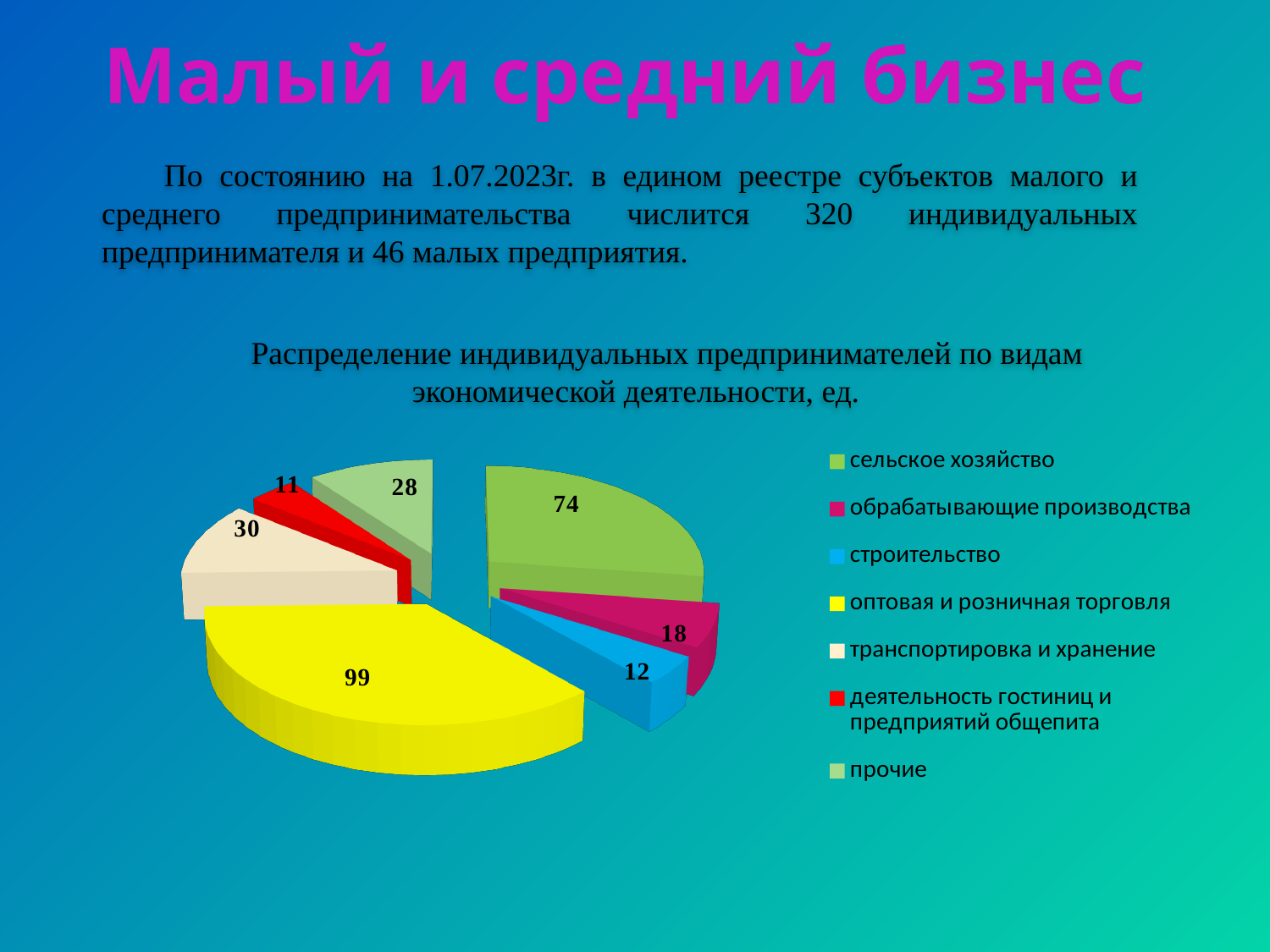
Which category has the largest slice of the pie? оптовая и розничная торговля How many categories does the pie chart have? 7 Which category has the smallest slice of the pie? деятельность гостиниц и предприятий общепита What is the difference between the values for оптовая и розничная торговля and сельское хозяйство? 25 What is the value for сельское хозяйство? 74 What is the title of the chart? Распределение индивидуальных предпринимателей по видам экономической деятельности, ед. What is the value for деятельность гостиниц и предприятий общепита? 11 What type of chart is shown on the slide? pie chart What is the value for оптовая и розничная торговля? 99 What is the value for транспортировка и хранение? 30 Which is larger, the value for обрабатывающие производства or the value for прочие? прочие What is the value for строительство? 12